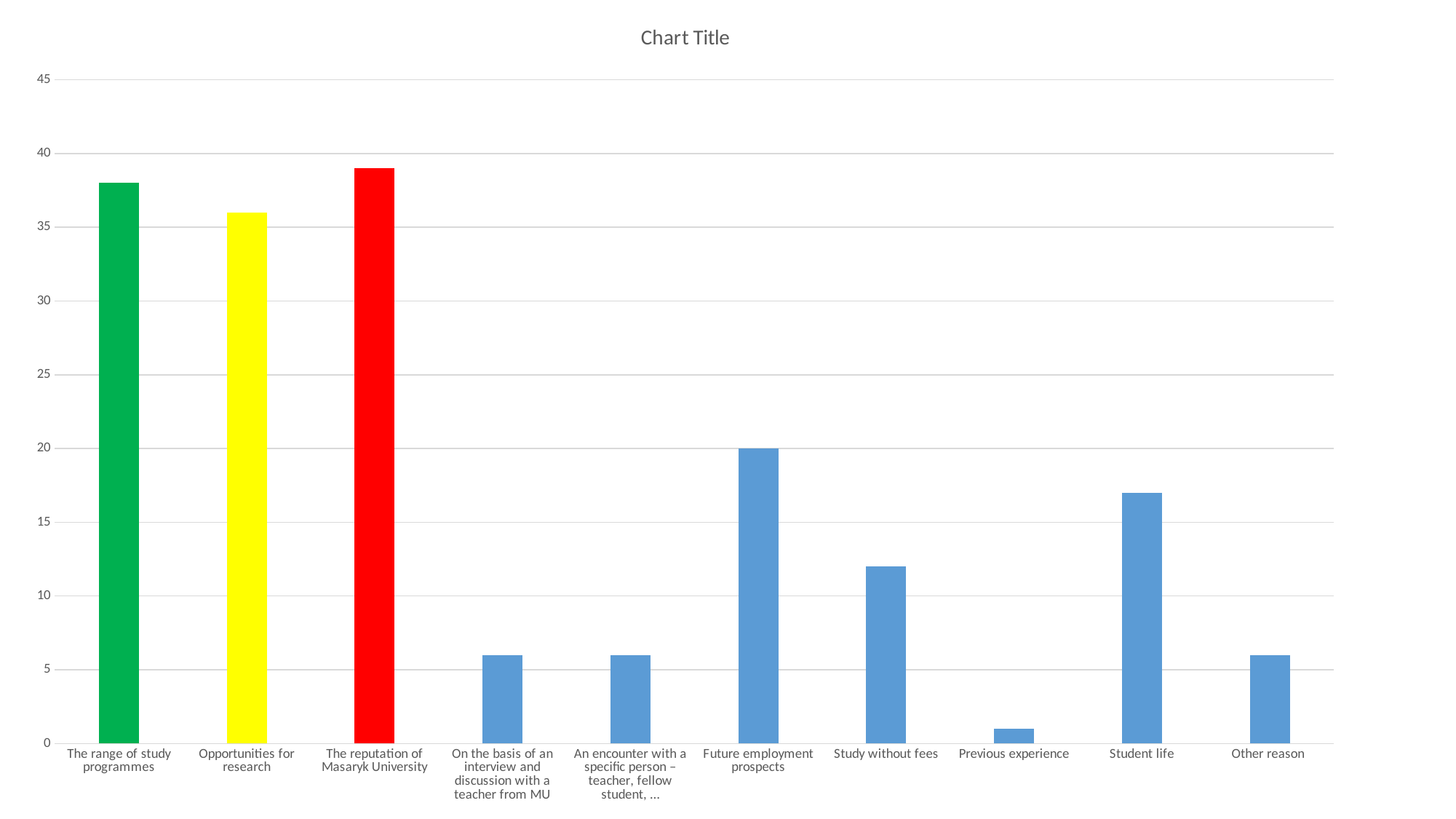
Which is larger, the value for Future employment prospects or the value for Study without fees? Future employment prospects Is the value for Student life greater or less than 20? less Which is larger, the value for Student life or the value for Other reason? Student life What type of chart is shown on the slide? bar chart Is the value for Previous experience greater or less than 5? less What is the title of the chart? Chart Title Which category has the lowest value? Previous experience Is the value for Study without fees greater or less than 10? greater How many categories are shown on the x axis of the chart? 10 What is the value for Future employment prospects? 20 What colour is the bar for The reputation of Masaryk University? red